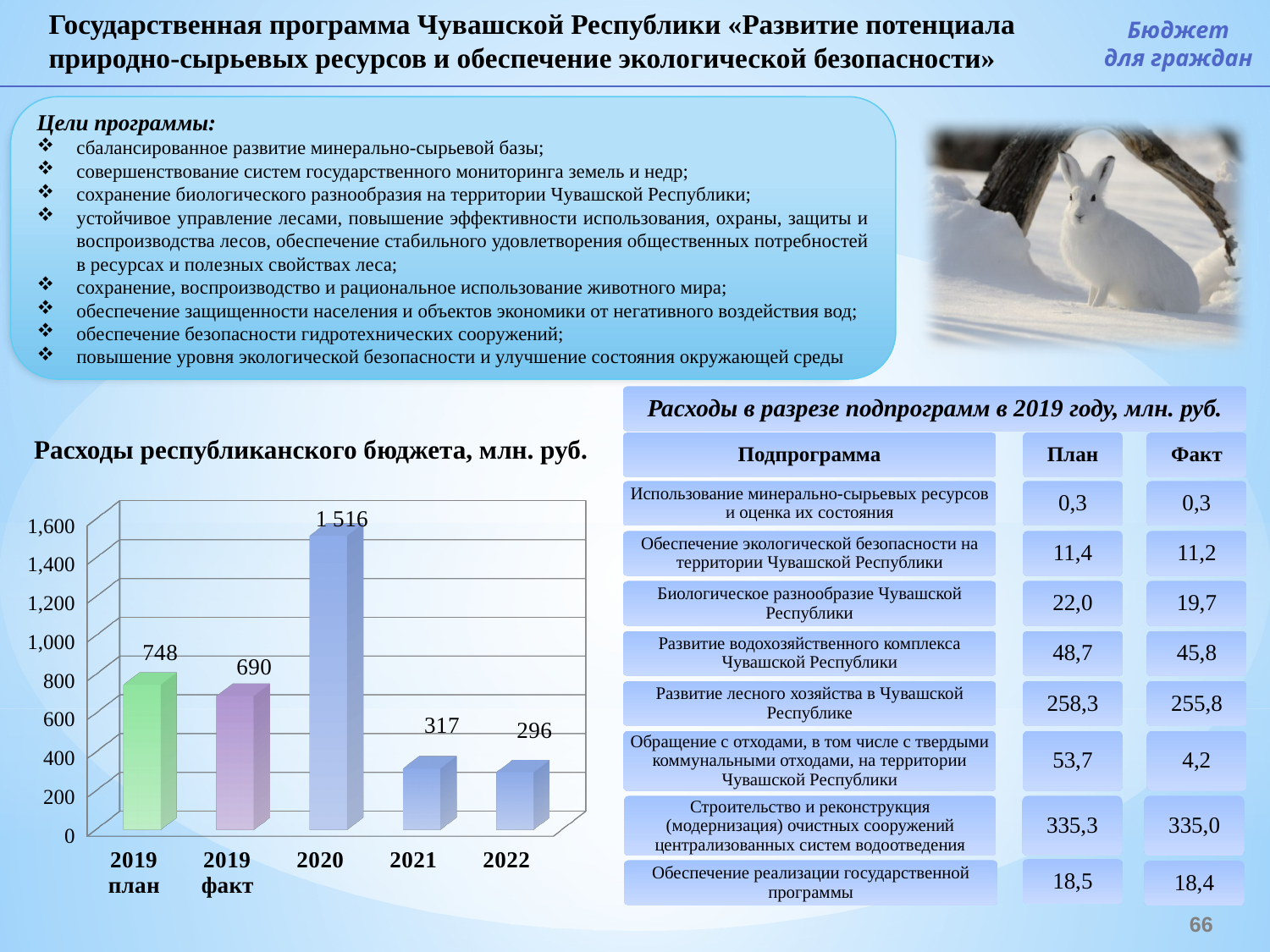
What kind of chart is 'Расходы республиканского бюджета, млн. руб.'? bar chart What is the value for '2019 факт' in the chart? 690 Which is larger, the value for 2021 or the value for 2022? 2021 What is the difference between the values for '2019 план' and '2019 факт'? 58 Which category has the lowest value in the chart? 2022 Which category has the highest value in the chart? 2020 Is the value for 2020 greater or less than 1,400? greater What is the value for 2022 in the chart? 296 What is the value for '2019 план' in the chart? 748 How many categories are shown on the x axis of the chart? 5 What is the value for 2020 in the chart 'Расходы республиканского бюджета, млн. руб.'? 1 516 What is the difference between the values for 2021 and 2022? 21